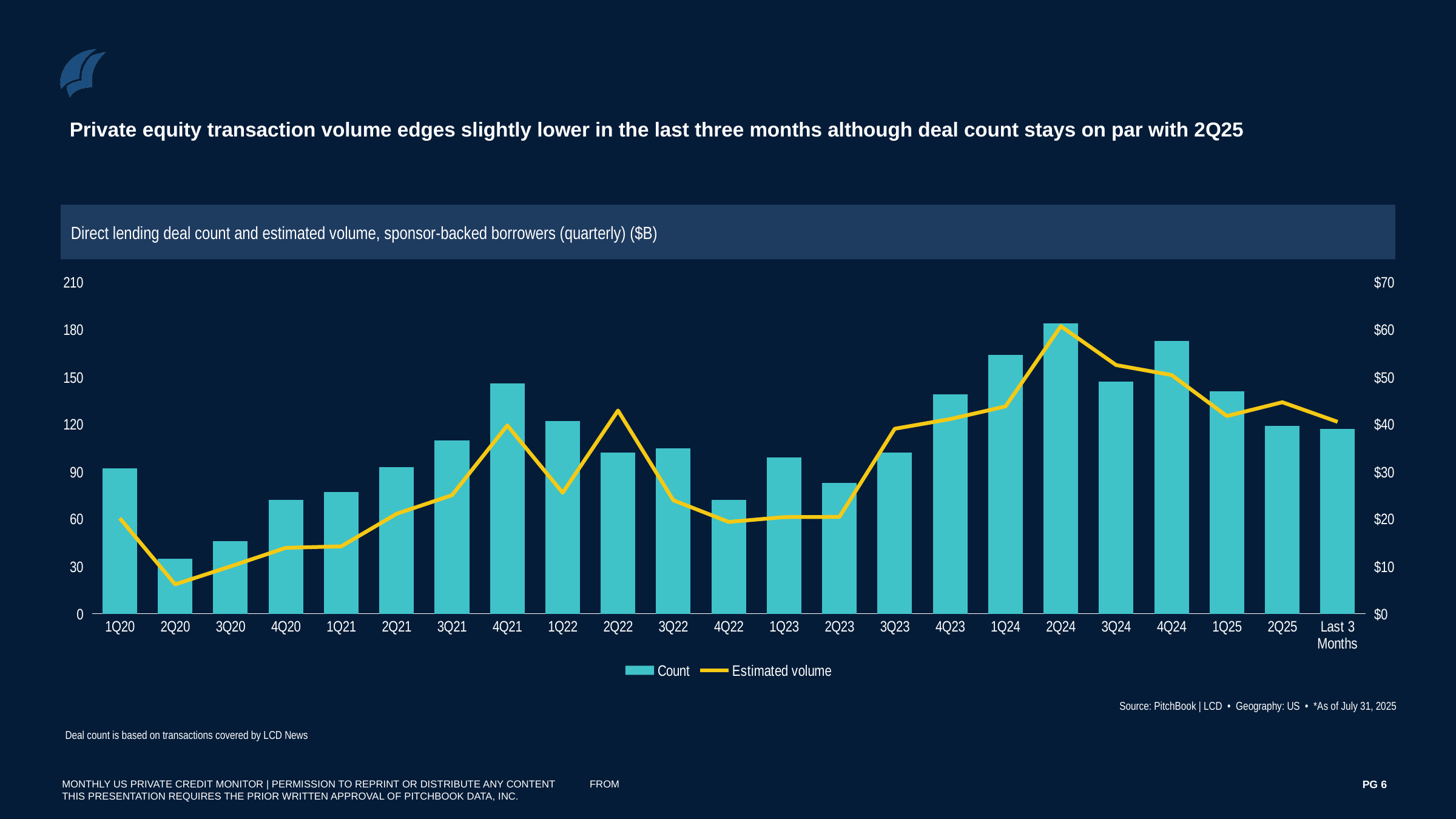
How many series does the legend list? 2 Is the deal count for 1Q24 greater or less than 150? greater Which period has the lowest deal count? 2Q20 Is the estimated volume for 4Q22 greater or less than $30? less Does the deal count rise or fall from 2Q24 to Last 3 Months? fall Which has the higher deal count, 4Q21 or 1Q22? 4Q21 What kind of chart is shown on the slide? Combined bar and line chart Which series is shown as a yellow line? Estimated volume How many periods are shown on the x axis? 23 Which period has the highest estimated volume? 2Q24 Which period has the highest deal count? 2Q24 Which period has the lowest estimated volume? 2Q20